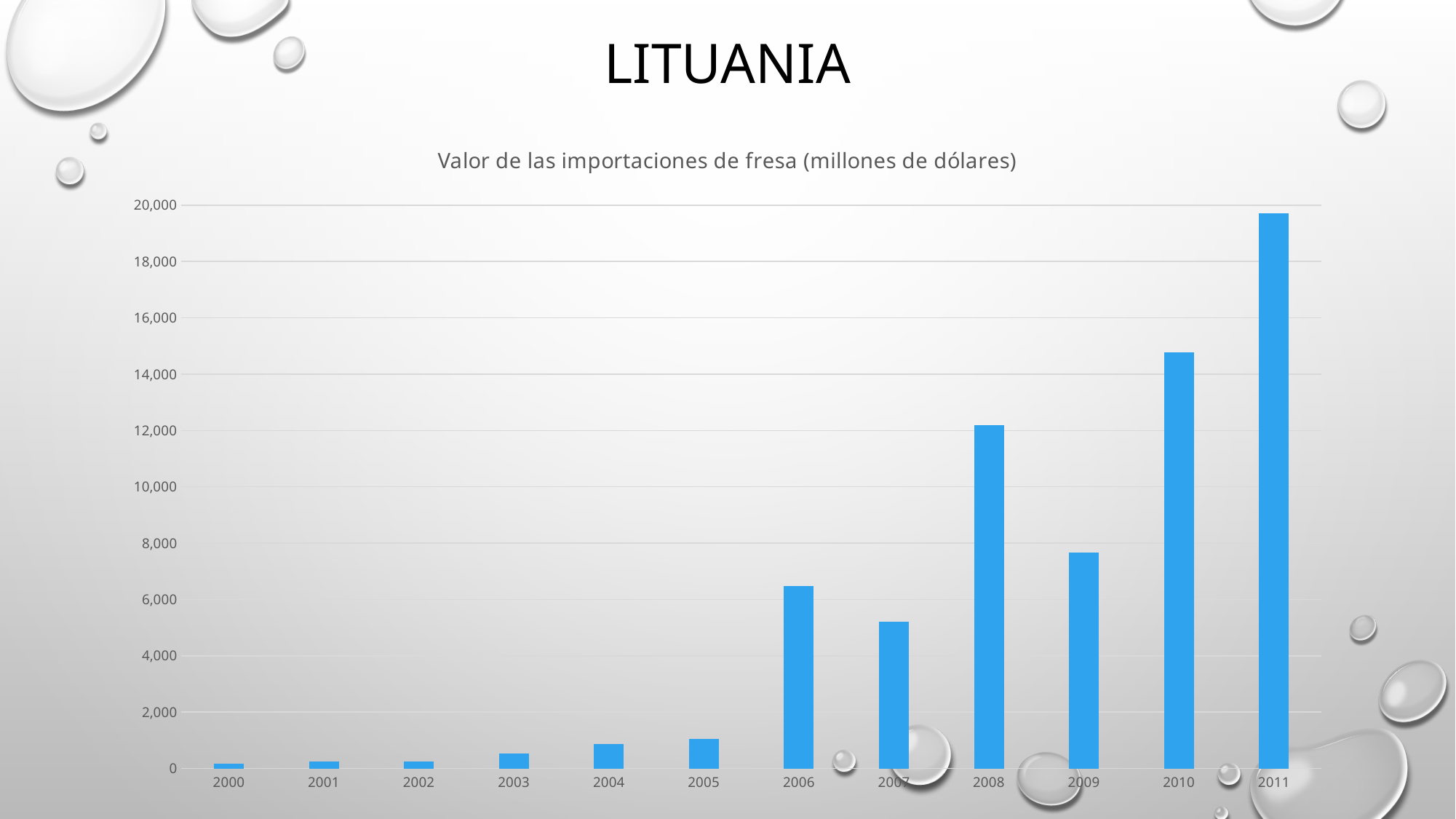
Which year has the highest value of strawberry imports? 2011 Is the value for 2011 greater or less than 18,000? greater Which year has the larger value, 2008 or 2009? 2008 Is the value for 2006 greater or less than 6,000? greater Is the value for 2005 greater or less than 2,000? less How many years are shown on the x axis of the chart? 12 What kind of chart is shown on the slide? Bar chart Which year has the larger value, 2006 or 2007? 2006 What is the title of the chart? Valor de las importaciones de fresa (millones de dólares)